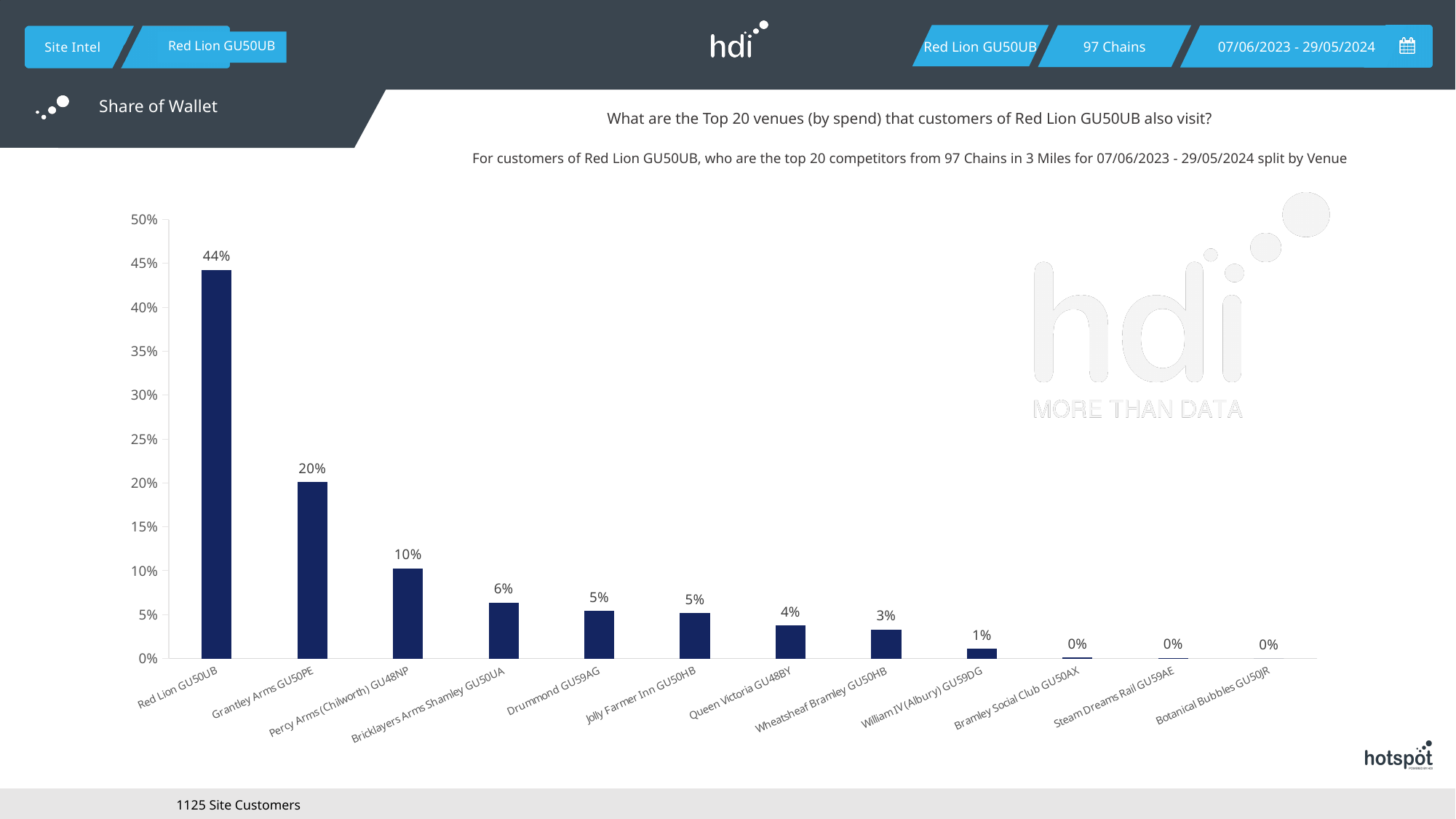
What is the difference between the values for Red Lion GU50UB and Grantley Arms GU50PE? 24 percentage points Is the value for Red Lion GU50UB greater or less than 40%? greater Do the values rise or fall moving left to right along the x axis? fall What is the value for William IV (Albury) GU59DG? 1% What is the value for Queen Victoria GU48BY? 4% What kind of chart is shown on the slide? bar chart Which is larger, the value for Grantley Arms GU50PE or Percy Arms (Chilworth) GU48NP? Grantley Arms GU50PE What is the value for Percy Arms (Chilworth) GU48NP? 10% What is the value for Red Lion GU50UB? 44% How many venues are shown on the x axis? 12 Which venue has the highest value? Red Lion GU50UB What is the value for Grantley Arms GU50PE? 20%